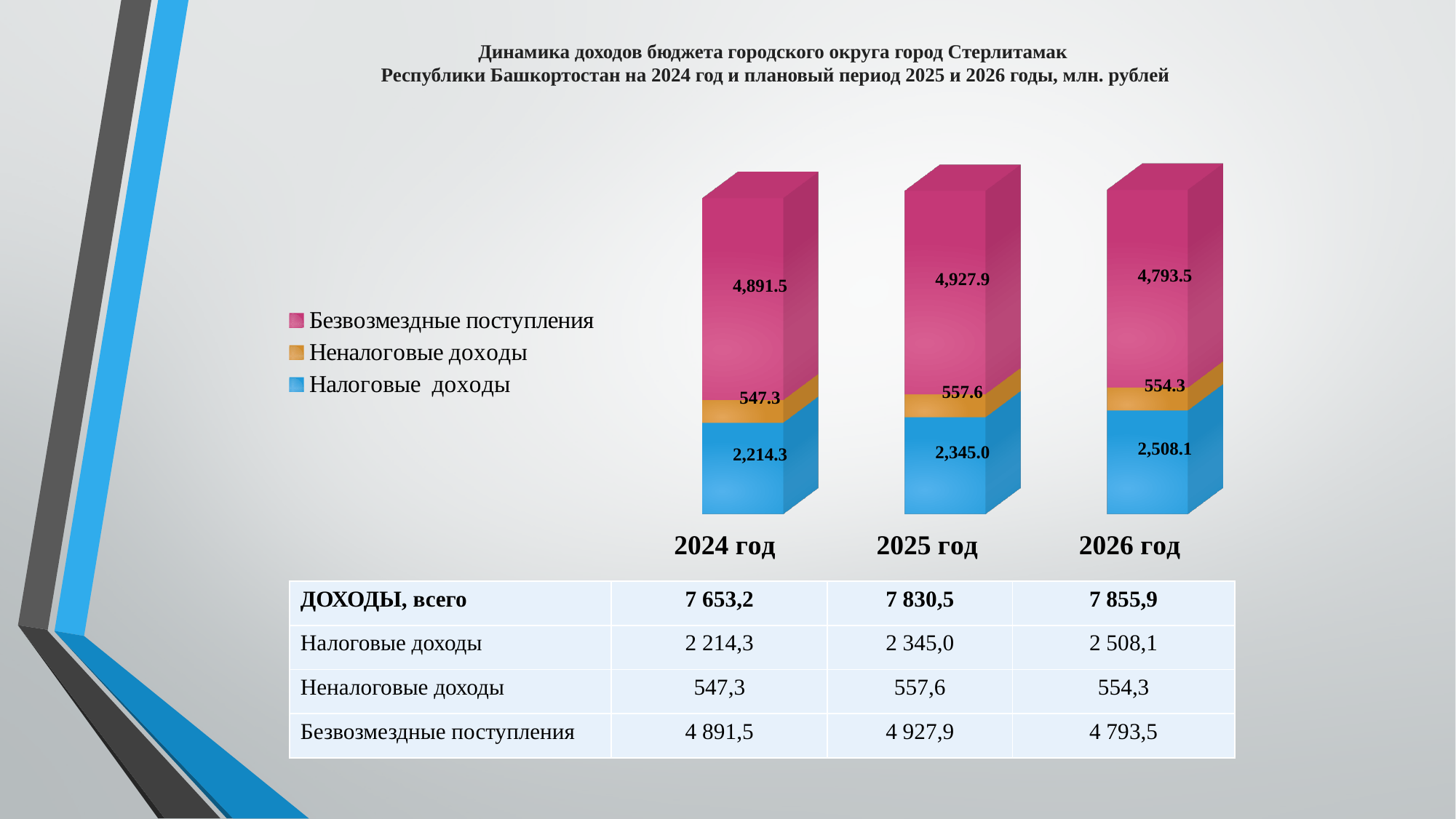
In which year is Налоговые доходы the highest? 2026 год What is the difference between Налоговые доходы in 2026 год and in 2024 год? 293.8 Does Налоговые доходы rise or fall from 2024 год to 2026 год? Rise How many series does the legend list? 3 What is the value of Неналоговые доходы for 2025 год? 557.6 What is the value of Налоговые доходы for 2024 год? 2,214.3 What is the total of the stacked bar for 2025 год? 7,830.5 In which year is Неналоговые доходы the lowest? 2024 год How many years are shown on the x axis of the chart? 3 What is the value of Безвозмездные поступления for 2026 год? 4,793.5 What kind of chart is shown on the slide? Stacked bar chart Which is larger: Безвозмездные поступления in 2025 год or in 2026 год? 2025 год